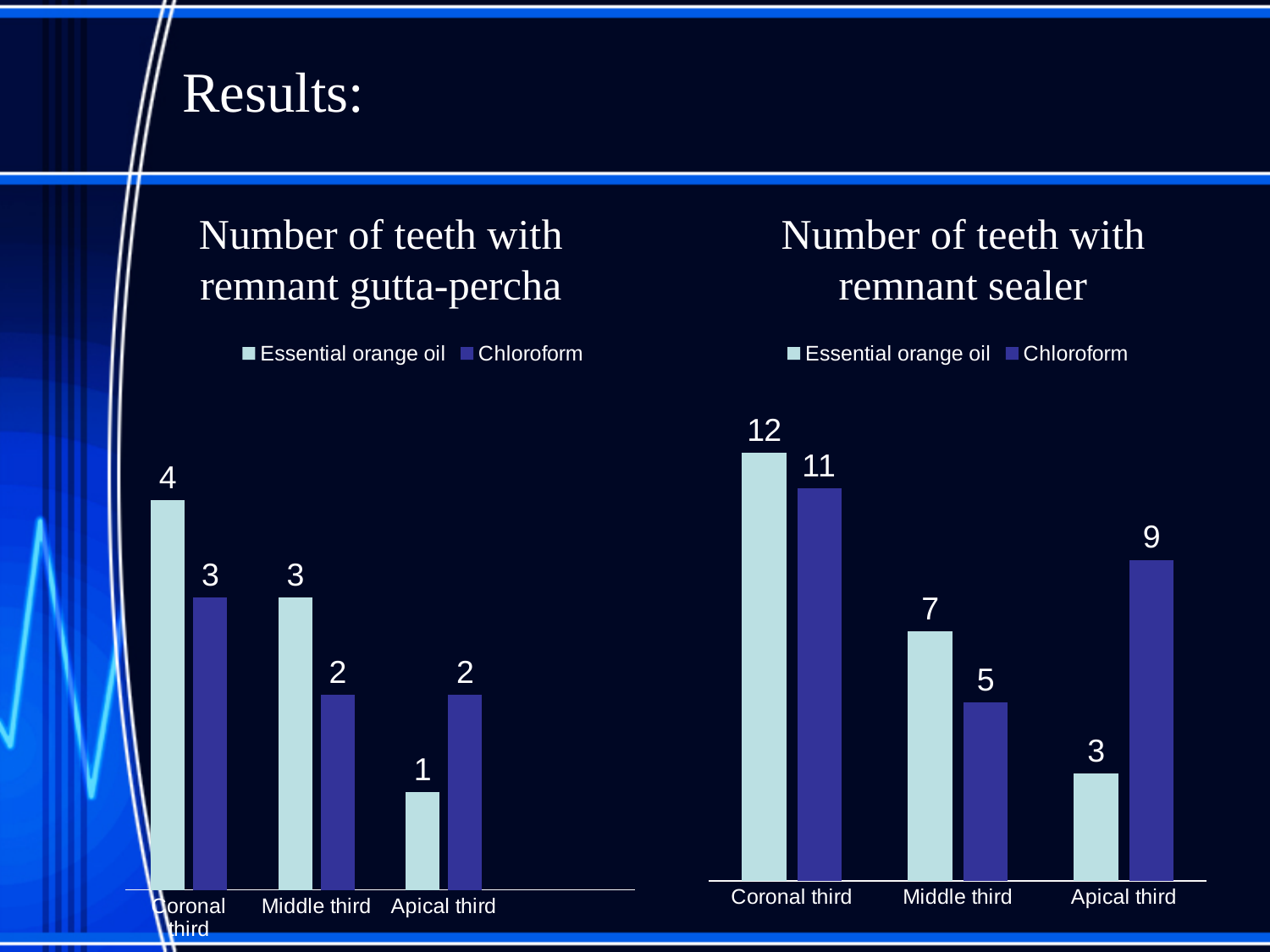
In the 'Number of teeth with remnant sealer' chart, which is larger in the Apical third: Essential orange oil or Chloroform? Chloroform In the 'Number of teeth with remnant sealer' chart, what is the value for Essential orange oil in the Coronal third? 12 In the 'Number of teeth with remnant sealer' chart, what is the value for Chloroform in the Apical third? 9 In the 'Number of teeth with remnant sealer' chart, which category has the lowest value for Essential orange oil? Apical third How many series does the legend of the 'Number of teeth with remnant sealer' chart list? 2 In the 'Number of teeth with remnant sealer' chart, what is the difference between Essential orange oil and Chloroform in the Middle third? 2 In the 'Number of teeth with remnant gutta-percha' chart, how many categories are shown on the x axis? 3 In the 'Number of teeth with remnant gutta-percha' chart, what is the value for Chloroform in the Apical third? 2 In the 'Number of teeth with remnant sealer' chart, do the Essential orange oil values rise or fall from Coronal third to Apical third? Fall In the 'Number of teeth with remnant gutta-percha' chart, which category has the highest value for Essential orange oil? Coronal third What kind of chart is the 'Number of teeth with remnant gutta-percha' chart? Bar chart In the 'Number of teeth with remnant gutta-percha' chart, what is the value for Essential orange oil in the Coronal third? 4